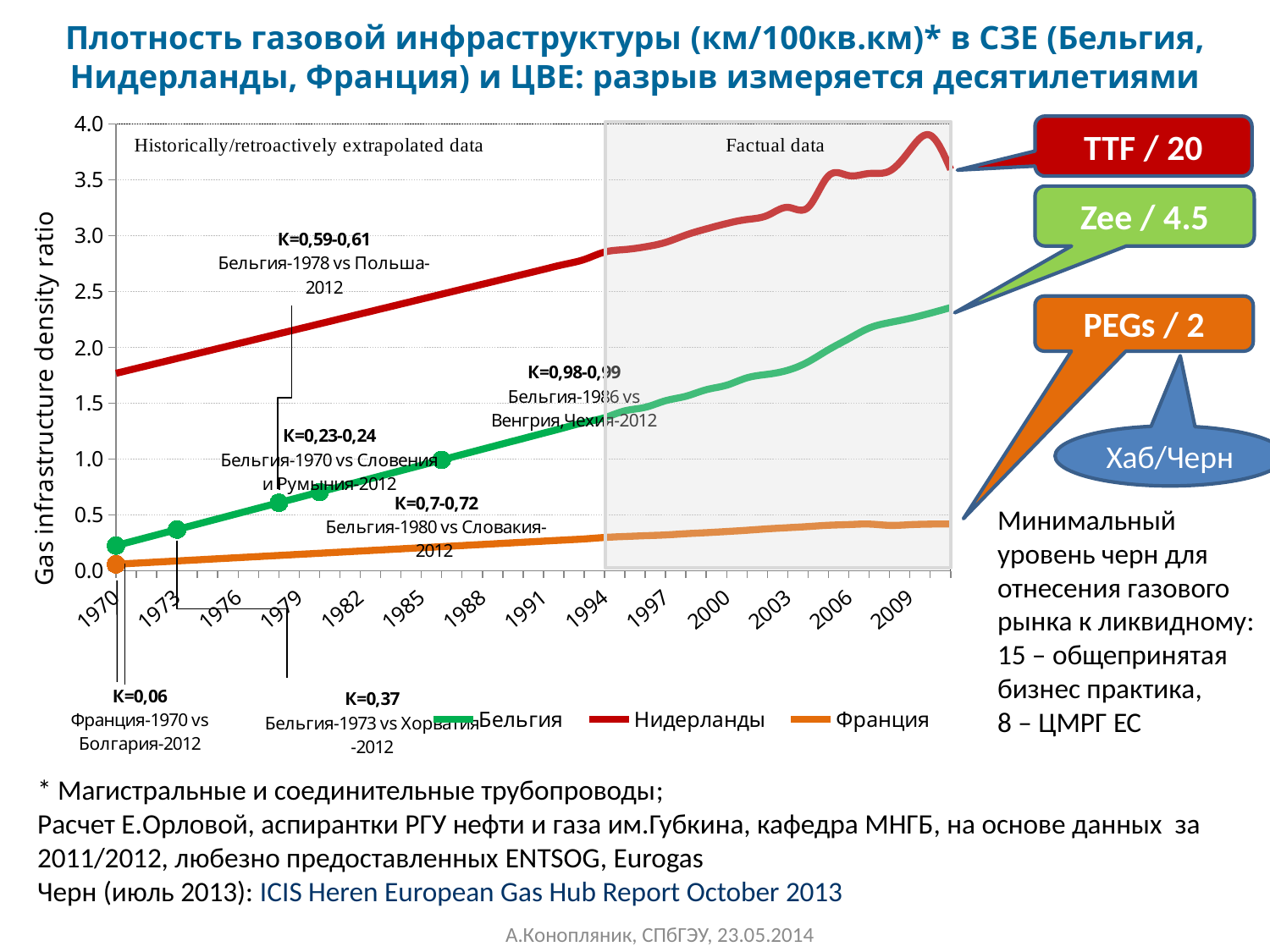
Which series are listed in the chart legend? Бельгия, Нидерланды, Франция Which series has the lowest values across the whole period shown? Франция Is the value for Франция in 2009 greater or less than 1.0? less Does the Бельгия series rise or fall from 1970 to 2009? rises How many series does the chart legend list? 3 Is the value for Нидерланды in 1970 greater or less than 1.5? greater Is the highest value reached by the Нидерланды line greater or less than 3.5? greater Which is larger in 2000, the value for Бельгия or the value for Франция? Бельгия Which series has the highest value in 2009? Нидерланды What kind of chart is shown on the slide? line chart What is the title of the vertical axis of the chart? Gas infrastructure density ratio